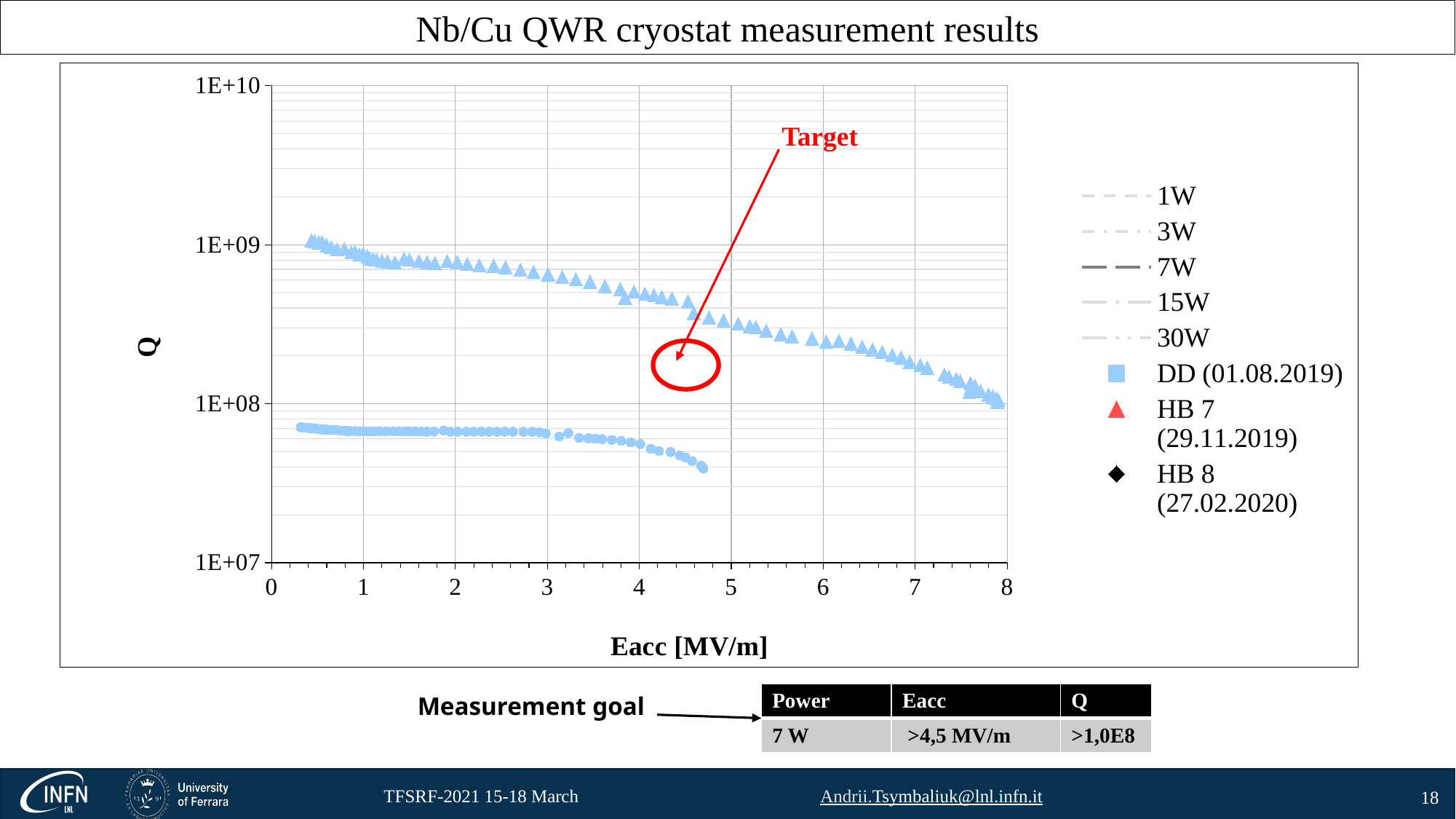
Is the Q value of the upper (triangle) series at Eacc = 4.5 MV/m greater or less than 1E+08? greater What is the lowest value shown on the y axis of the chart? 1E+07 Do the Q values of the lower (circle) series rise or fall as Eacc increases from 3 to 4.7 MV/m? fall What is the label of the y axis of the chart? Q What is the highest value shown on the x axis of the chart? 8 Which series reaches higher Q values, the triangle series or the circle series? the triangle series Is the Q value of the upper (triangle) series at Eacc = 1 MV/m greater or less than 1E+09? less Is the Q value of the lower (circle) series at Eacc = 4 MV/m greater or less than 1E+08? less How many entries does the chart legend list? 8 What kind of chart is shown on the slide? scatter chart Do the Q values of the upper (triangle) series rise or fall as Eacc increases? fall